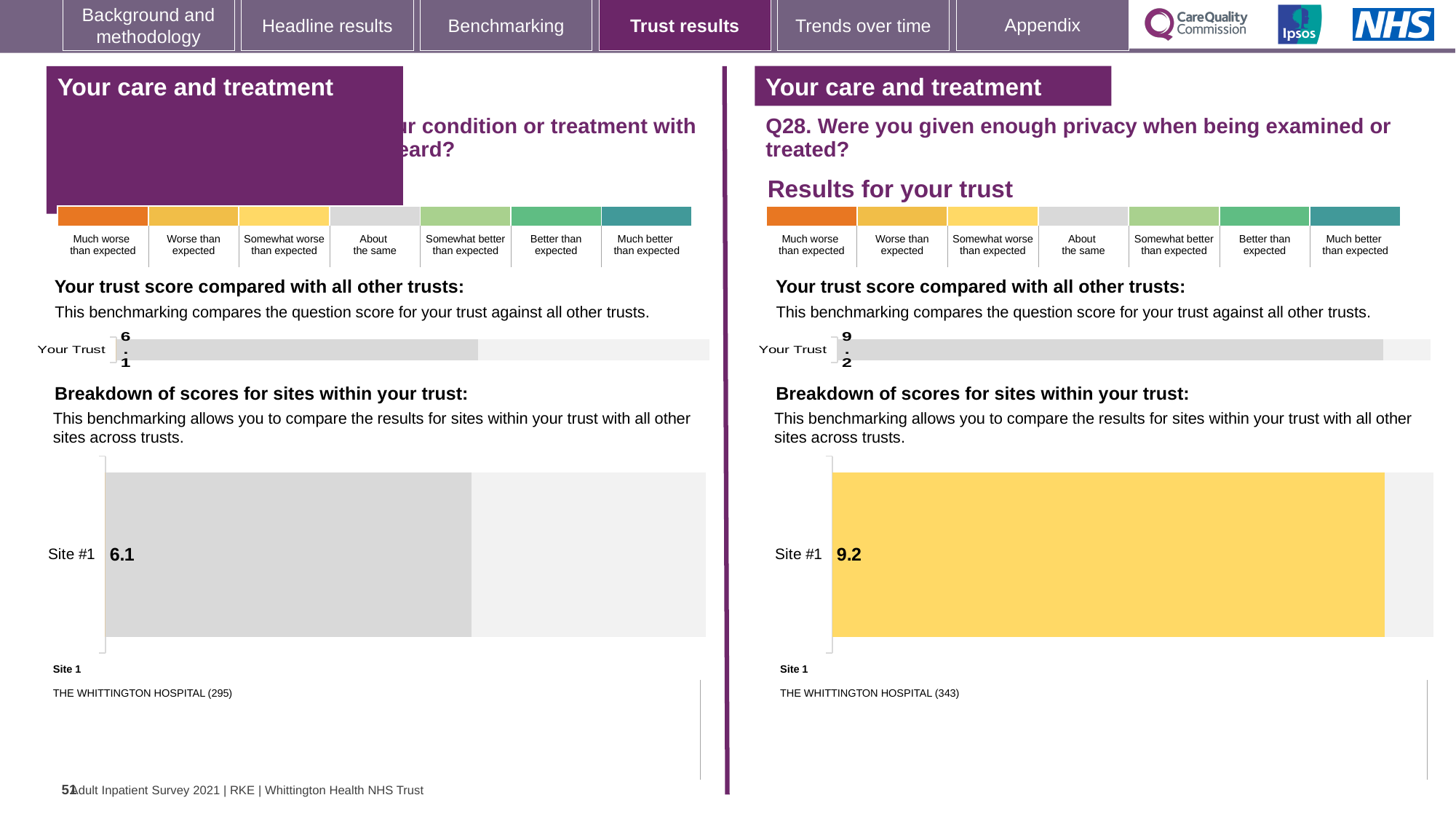
How many benchmark categories does the colour key above the charts list (from 'Much worse than expected' to 'Much better than expected')? 7 In the 'Breakdown of scores for sites within your trust' chart on the left half of the slide, what is the score for Site #1? 6.1 What is the difference between the Site #1 score in the right-hand (Q28) breakdown chart and the Site #1 score in the left-hand breakdown chart? 3.1 How many sites are shown in the 'Breakdown of scores for sites within your trust' chart on the right half of the slide (Q28)? 1 In the 'Breakdown of scores for sites within your trust' chart on the right half of the slide (Q28), what is the score for Site #1? 9.2 Which site name is listed as Site 1 under the breakdown chart on the right half of the slide (Q28)? THE WHITTINGTON HOSPITAL (343) On the right half of the slide (Q28), what is the score shown for Your Trust in the 'Your trust score compared with all other trusts' chart? 9.2 Which is larger: the Site #1 score in the left-hand breakdown chart or the Site #1 score in the right-hand (Q28) breakdown chart? The right-hand (Q28) chart According to the colour key, which benchmark category does the grey Site #1 bar on the left half of the slide correspond to? About the same On the left half of the slide, what is the score shown for Your Trust in the 'Your trust score compared with all other trusts' chart? 6.1 What type of chart is used to show the Site #1 score in the 'Breakdown of scores for sites within your trust' section on the right half of the slide? Bar chart What colour is the Site #1 bar in the breakdown chart on the right half of the slide (Q28)? Yellow